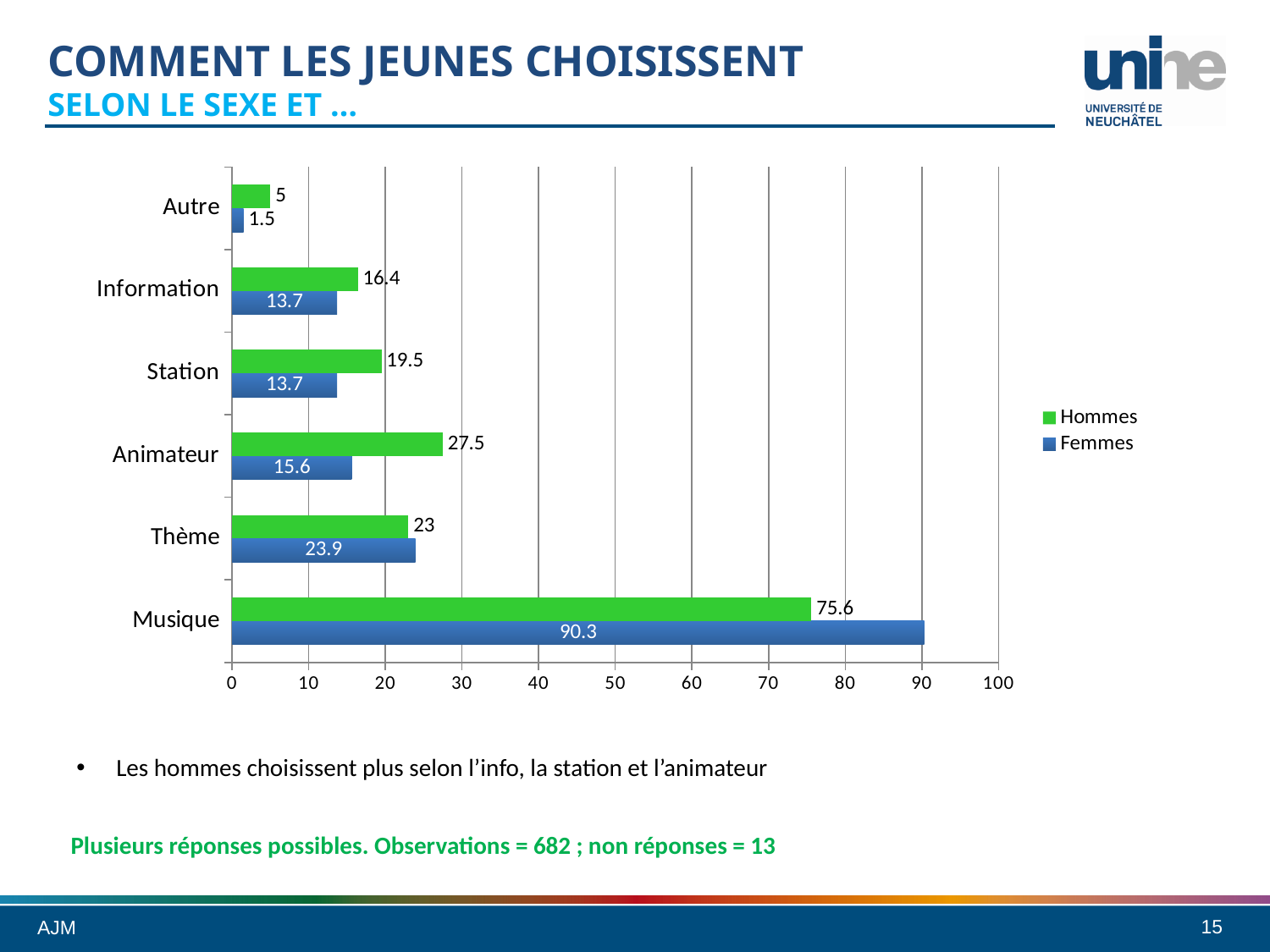
What is the difference between the Femmes and Hommes values for Musique? 14.7 What is the value for Hommes in the Musique category? 75.6 How many categories are shown on the chart? 6 Which category has the highest value for Femmes? Musique Which is larger for Station: the Hommes value or the Femmes value? Hommes Which category has the lowest value for Hommes? Autre What is the value for Femmes in the Autre category? 1.5 How many series does the legend list? 2 What is the value for Femmes in the Musique category? 90.3 What is the value for Hommes in the Animateur category? 27.5 Which colour represents the Hommes series in the chart? Green What kind of chart is shown on the slide? Bar chart